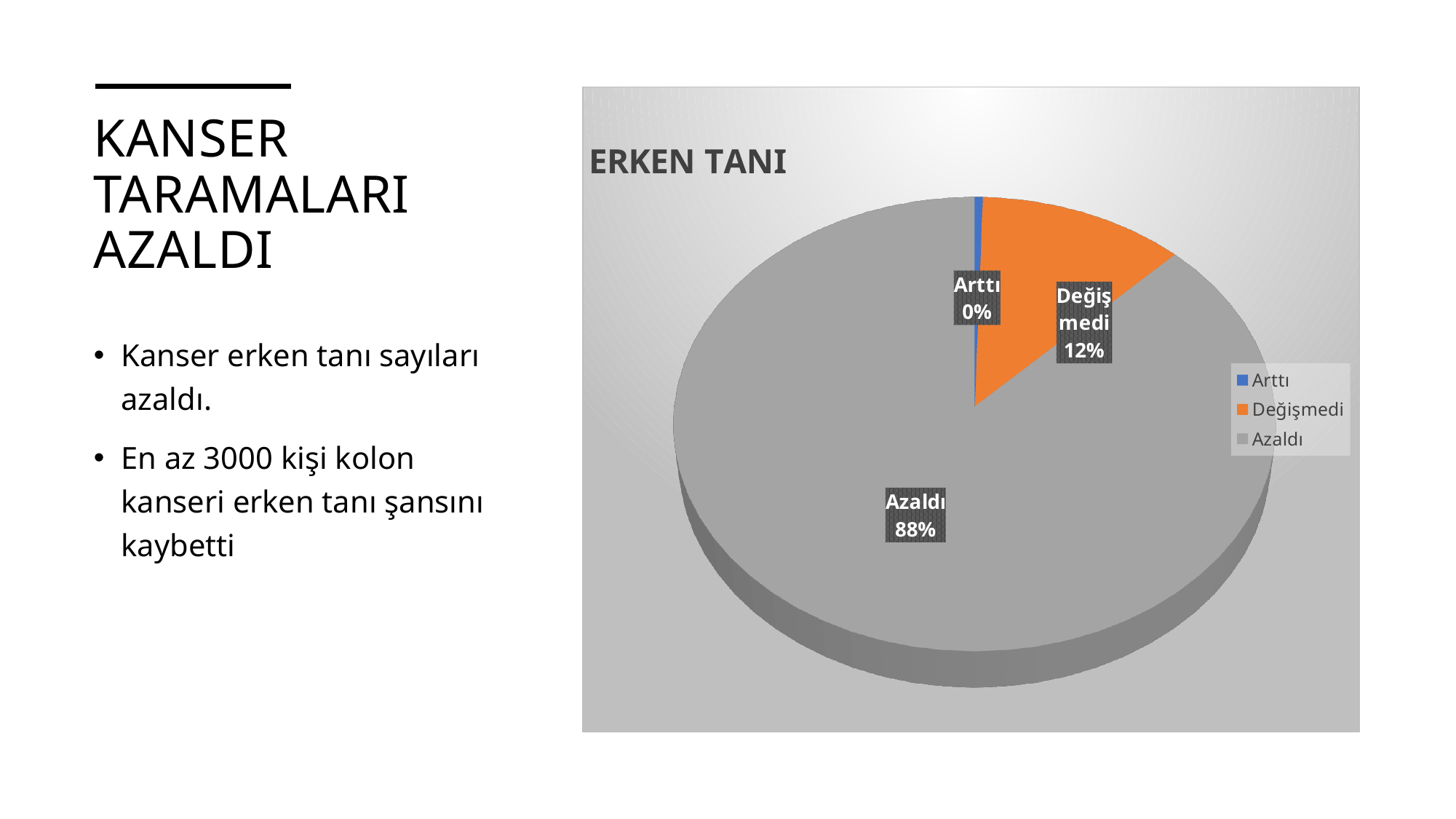
What share of the pie does Değişmedi take? 12% Which is larger, the Değişmedi slice or the Arttı slice? Değişmedi How many entries does the legend list? 3 What kind of chart is shown on the slide? pie chart What share of the pie does Azaldı take? 88% What colour is the Değişmedi slice? orange What value is shown for Arttı? 0% What is the title of the chart? ERKEN TANI Which category has the largest slice? Azaldı Which category has the smallest slice? Arttı How many categories does the pie chart show? 3 What is the difference between the Azaldı and Değişmedi shares? 76%